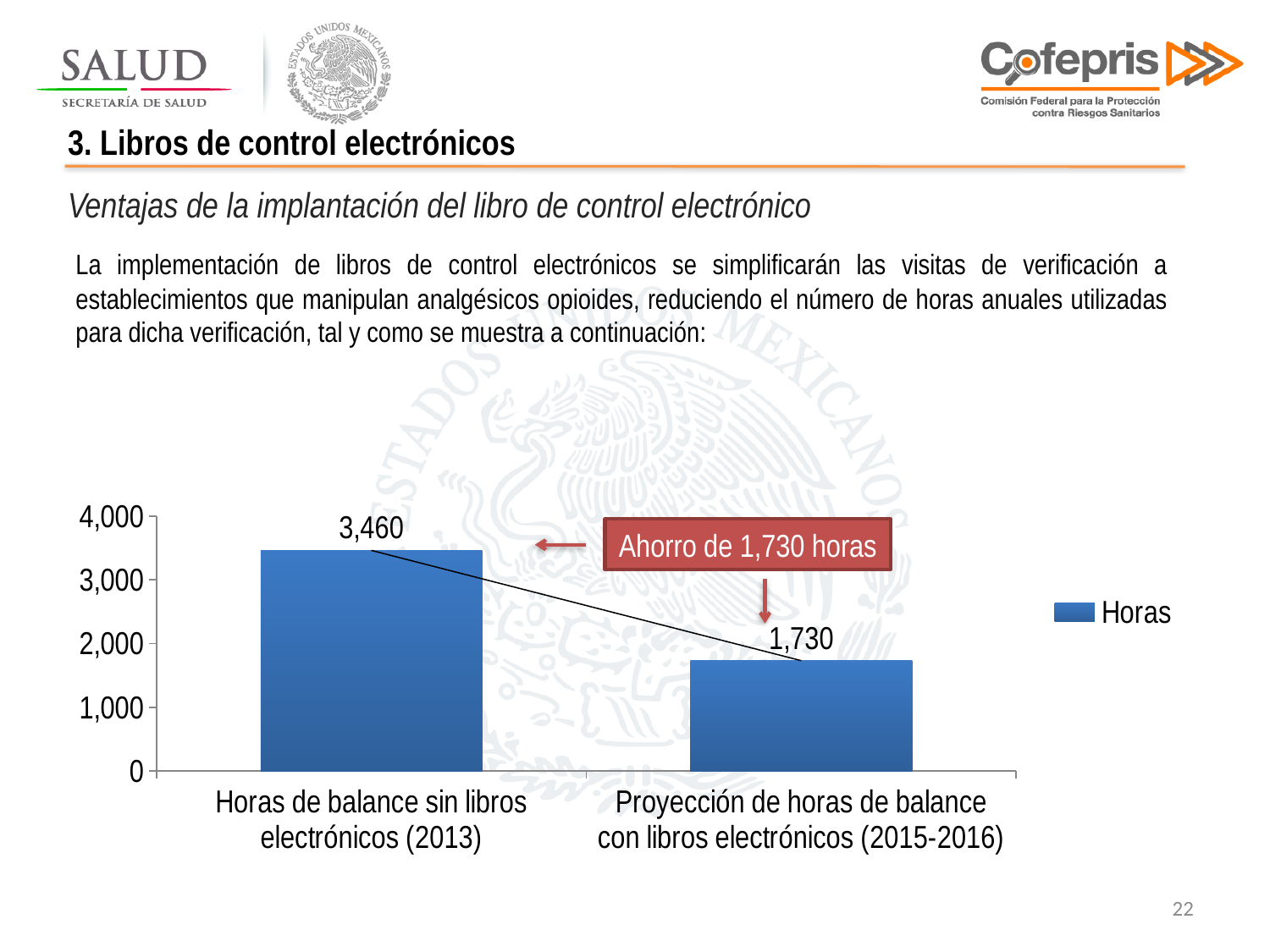
Which is larger: the hours for 2013 or the projected hours for 2015-2016? Horas de balance sin libros electrónicos (2013) What is the name of the series shown in the legend? Horas Which category has the highest value? Horas de balance sin libros electrónicos (2013) Is the value for 'Horas de balance sin libros electrónicos (2013)' greater or less than 3,000? greater Which category has the lowest value? Proyección de horas de balance con libros electrónicos (2015-2016) How many series does the legend list? 1 How many categories are shown on the chart? 2 What is the difference between the 2013 hours and the projected 2015-2016 hours? 1,730 What kind of chart is shown on the slide? Bar chart Is the value for 'Proyección de horas de balance con libros electrónicos (2015-2016)' greater or less than 2,000? less What is the value for 'Proyección de horas de balance con libros electrónicos (2015-2016)'? 1,730 What is the value for 'Horas de balance sin libros electrónicos (2013)'? 3,460